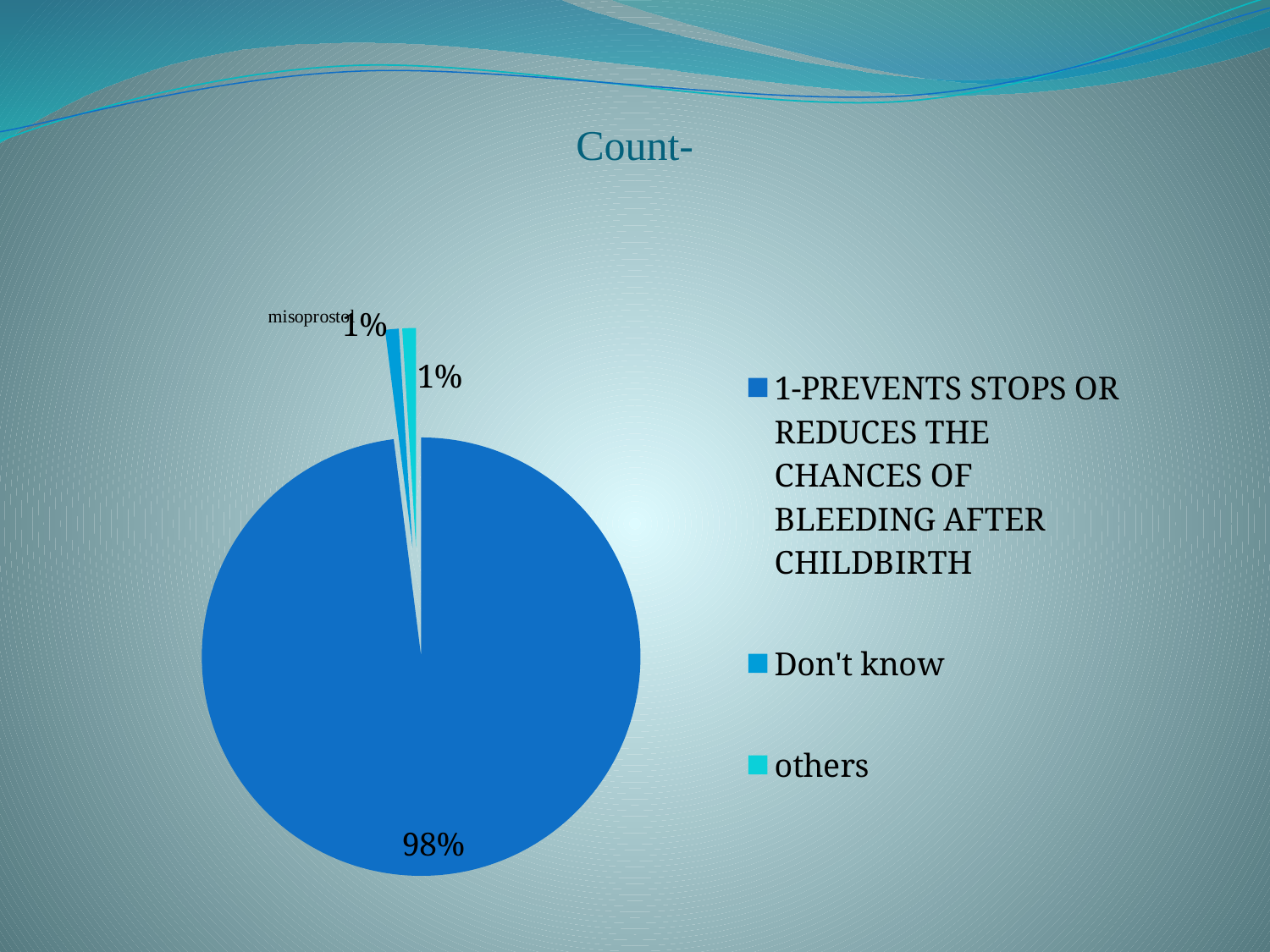
Which is larger, the slice for 'Don't know' or the slice for '1-PREVENTS STOPS OR REDUCES THE CHANCES OF BLEEDING AFTER CHILDBIRTH'? 1-PREVENTS STOPS OR REDUCES THE CHANCES OF BLEEDING AFTER CHILDBIRTH How many entries does the legend list? 3 How many slices does the pie chart have? 3 Which category has the largest slice of the pie? 1-PREVENTS STOPS OR REDUCES THE CHANCES OF BLEEDING AFTER CHILDBIRTH What is the difference in percentage points between the '1-PREVENTS STOPS OR REDUCES THE CHANCES OF BLEEDING AFTER CHILDBIRTH' slice and the 'others' slice? 97% What is the title of the chart? Count- What share of the pie is labelled '1-PREVENTS STOPS OR REDUCES THE CHANCES OF BLEEDING AFTER CHILDBIRTH'? 98% What share of the pie is labelled 'others'? 1% What is the combined share of the 'Don't know' and 'others' slices? 2% Which legend entry is shown in the lightest (cyan) colour? others What share of the pie is labelled 'Don't know'? 1% What kind of chart is shown on the slide? pie chart